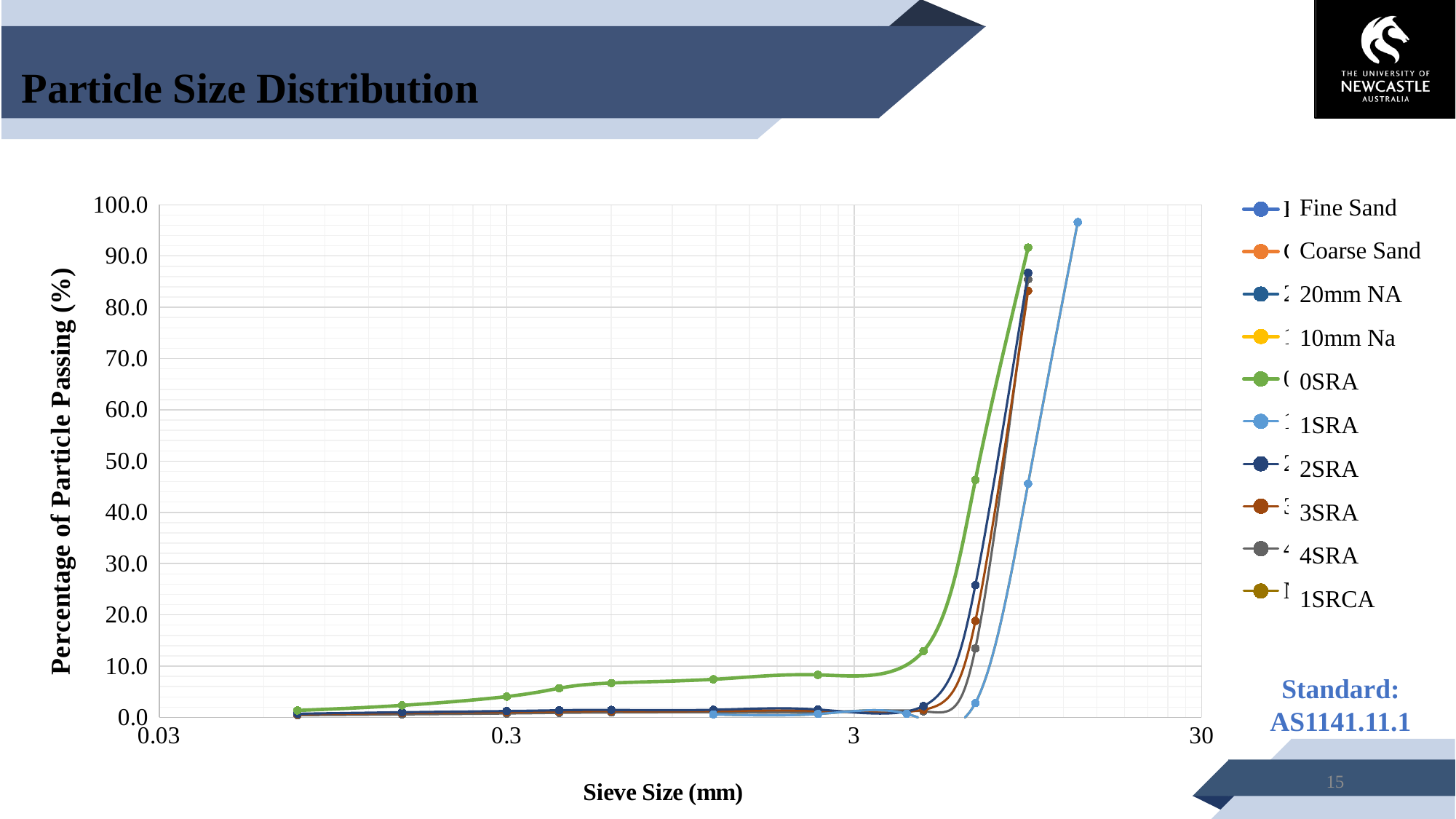
How many series does the legend list? 10 What is the label of the vertical axis? Percentage of Particle Passing (%) Which series has the highest percentage passing across the sieve sizes between 0.3 mm and 3 mm? 0SRA Is the value for 0SRA at a sieve size of 3 mm greater or less than 10? less How many tick labels are shown on the horizontal axis? 4 Is the highest value for 1SRA greater or less than 90? greater What is the title of the chart on the slide? Particle Size Distribution What is the maximum value shown on the vertical axis? 100.0 What kind of chart is shown on the slide? Line chart Which series reaches the highest percentage passing at its rightmost point? 1SRA Do the percentage passing values rise or fall as sieve size increases along the x axis? rise Is the highest value for 2SRA greater or less than 80? greater